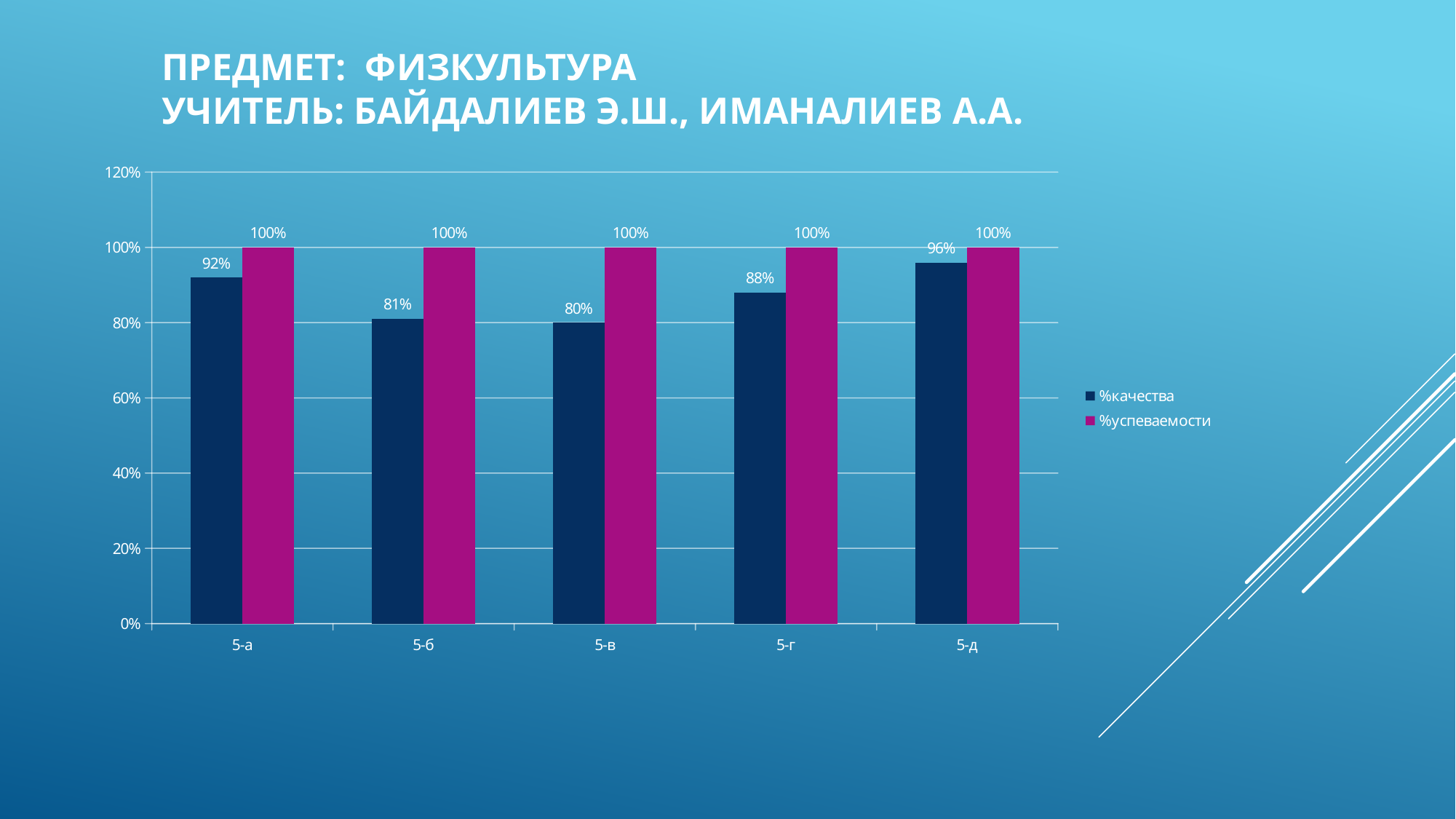
What kind of chart is shown on the slide? bar chart How many series does the legend list? 2 Is the %качества value for 5-б greater or less than 80%? greater Which class has the lowest %качества value? 5-в What is the %успеваемости value for class 5-в? 100% What is the %качества value for class 5-а? 92% Which colour represents the %успеваемости series? magenta Which class has the highest %качества value? 5-д What is the difference between the %качества values for 5-д and 5-г? 8% What is the %качества value for class 5-б? 81% How many classes are shown on the x axis? 5 Which is larger, the %качества value for 5-а or for 5-г? 5-а